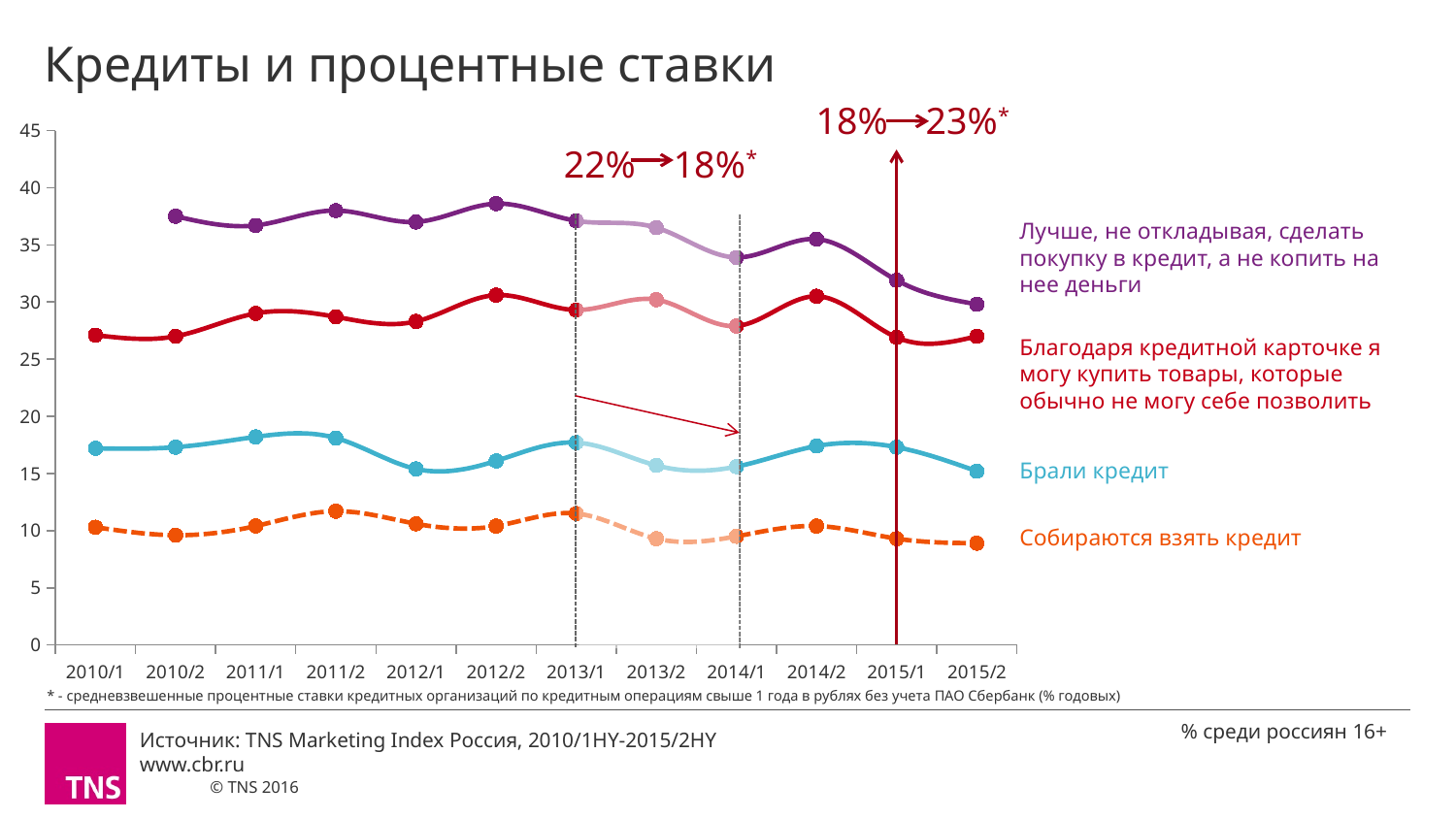
Which series has the highest values across the whole chart? Лучше, не откладывая, сделать покупку в кредит, а не копить на нее деньги Is the value for "Брали кредит" in 2012/1 greater or less than 20? less Is the value for "Благодаря кредитной карточке я могу купить товары, которые обычно не могу себе позволить" in 2015/1 greater or less than 25? greater Is the value for "Лучше, не откладывая, сделать покупку в кредит, а не копить на нее деньги" in 2015/2 greater or less than 35? less Which series has the lowest values across the whole chart? Собираются взять кредит How many series are plotted on the chart? 4 What kind of chart is shown on the slide? line chart Which is larger for "Благодаря кредитной карточке я могу купить товары, которые обычно не могу себе позволить": the value in 2010/1 or in 2012/2? 2012/2 Does the "Лучше, не откладывая, сделать покупку в кредит, а не копить на нее деньги" series rise or fall from 2013/1 to 2015/2? fall How many time periods are shown on the x axis? 12